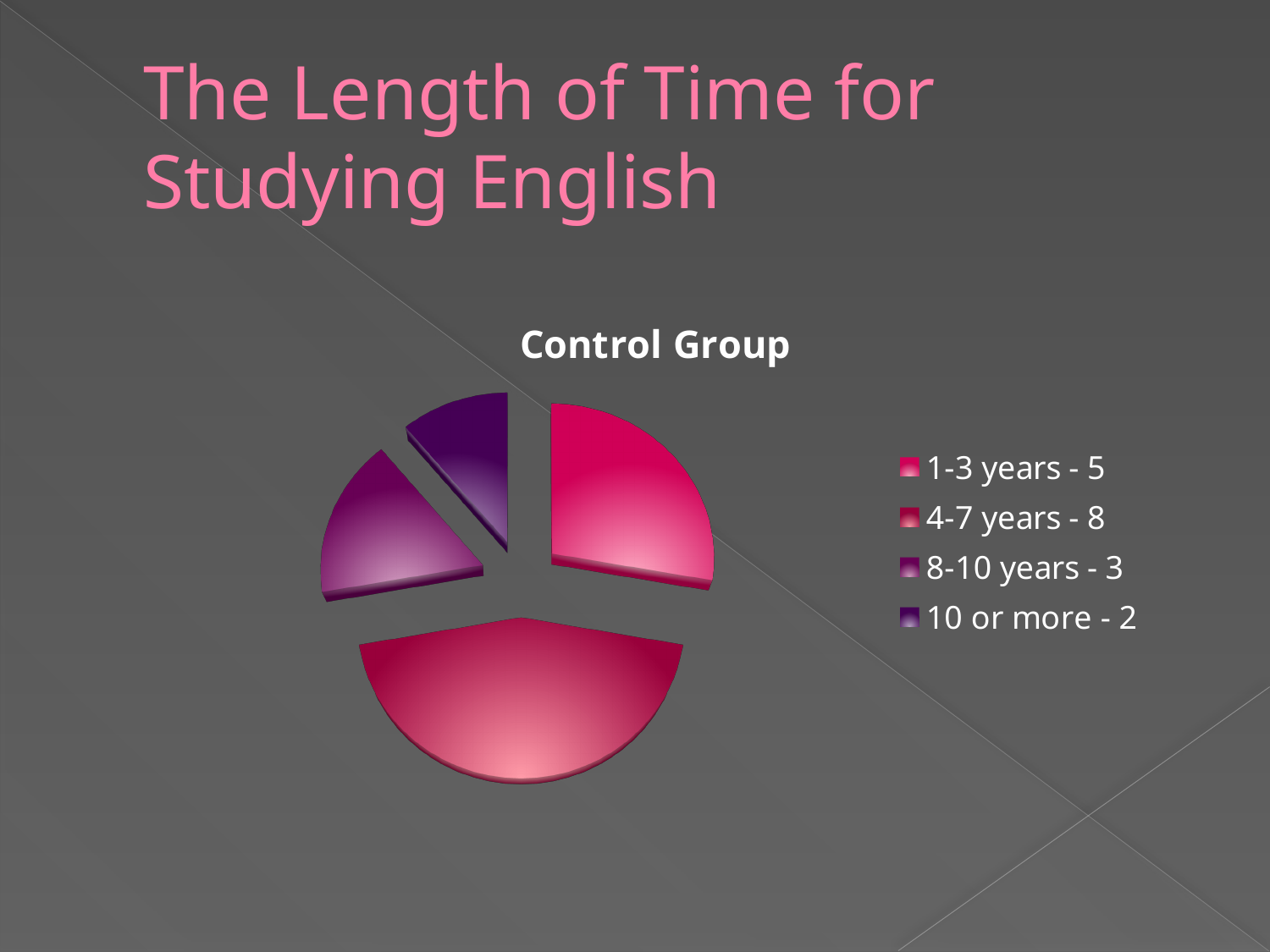
Which category has the smallest slice of the pie? 10 or more What kind of chart is shown on the slide? pie chart What is the title of the chart? Control Group What is the value for the 8-10 years category? 3 What is the value for the 4-7 years category? 8 Which is larger, the value for 8-10 years or the value for 10 or more? 8-10 years What is the value for the 10 or more category? 2 How many categories does the pie chart have? 4 What is the total of all the values in the pie chart? 18 What is the value for the 1-3 years category? 5 What is the difference between the values for 4-7 years and 1-3 years? 3 Which category has the largest slice of the pie? 4-7 years